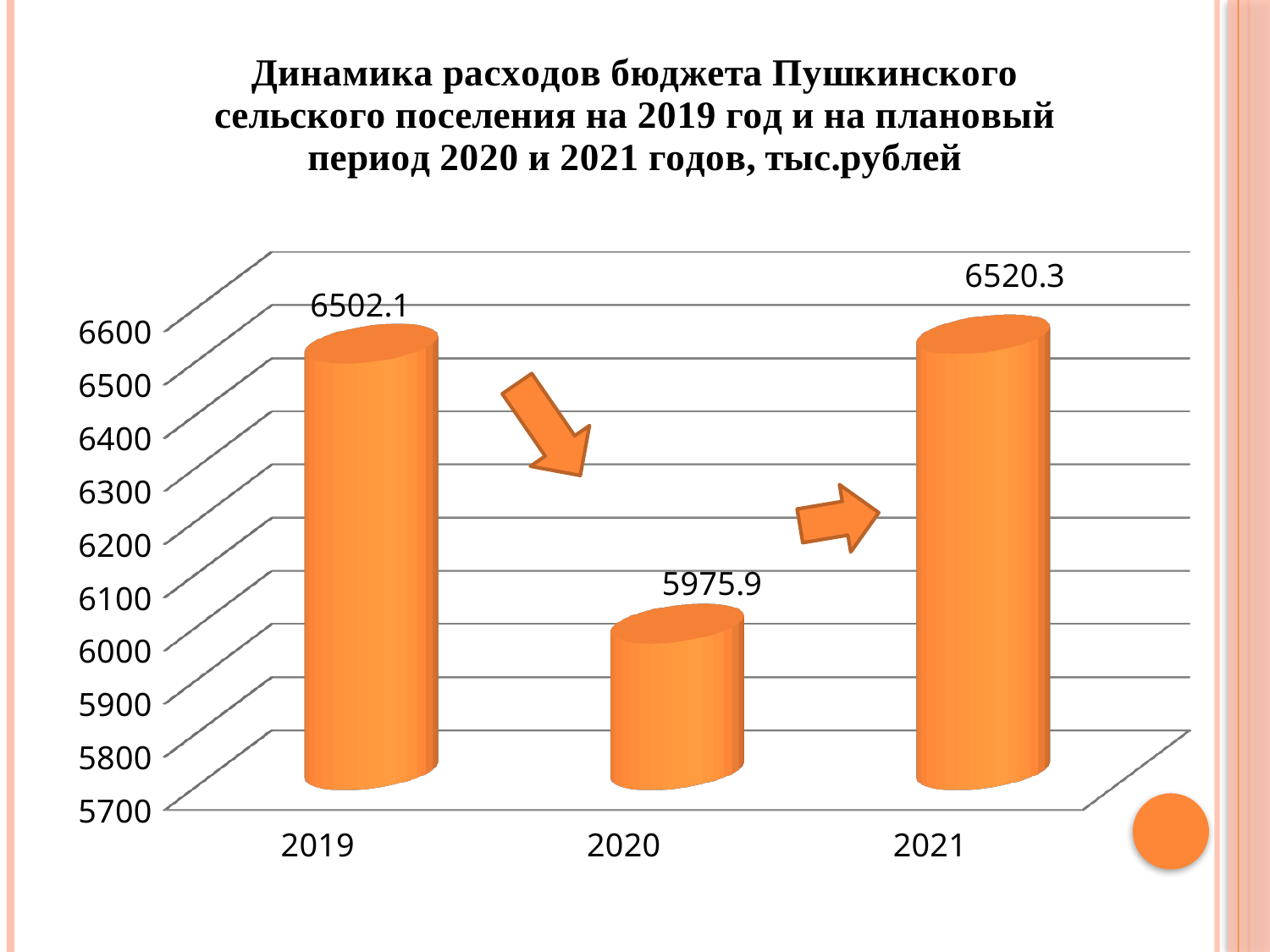
What is the value for 2021? 6520.3 What kind of chart is this? bar chart Is the value for 2020 greater or less than 6000? less What is the difference between the values for 2021 and 2019? 18.2 What is the value for 2020? 5975.9 How many years are shown on the chart? 3 What is the value for 2019? 6502.1 Which year has the lowest value? 2020 What unit is stated in the chart title? тыс.рублей What is the difference between the values for 2019 and 2020? 526.2 Which is larger, the value for 2019 or the value for 2020? 2019 Which year has the highest value? 2021